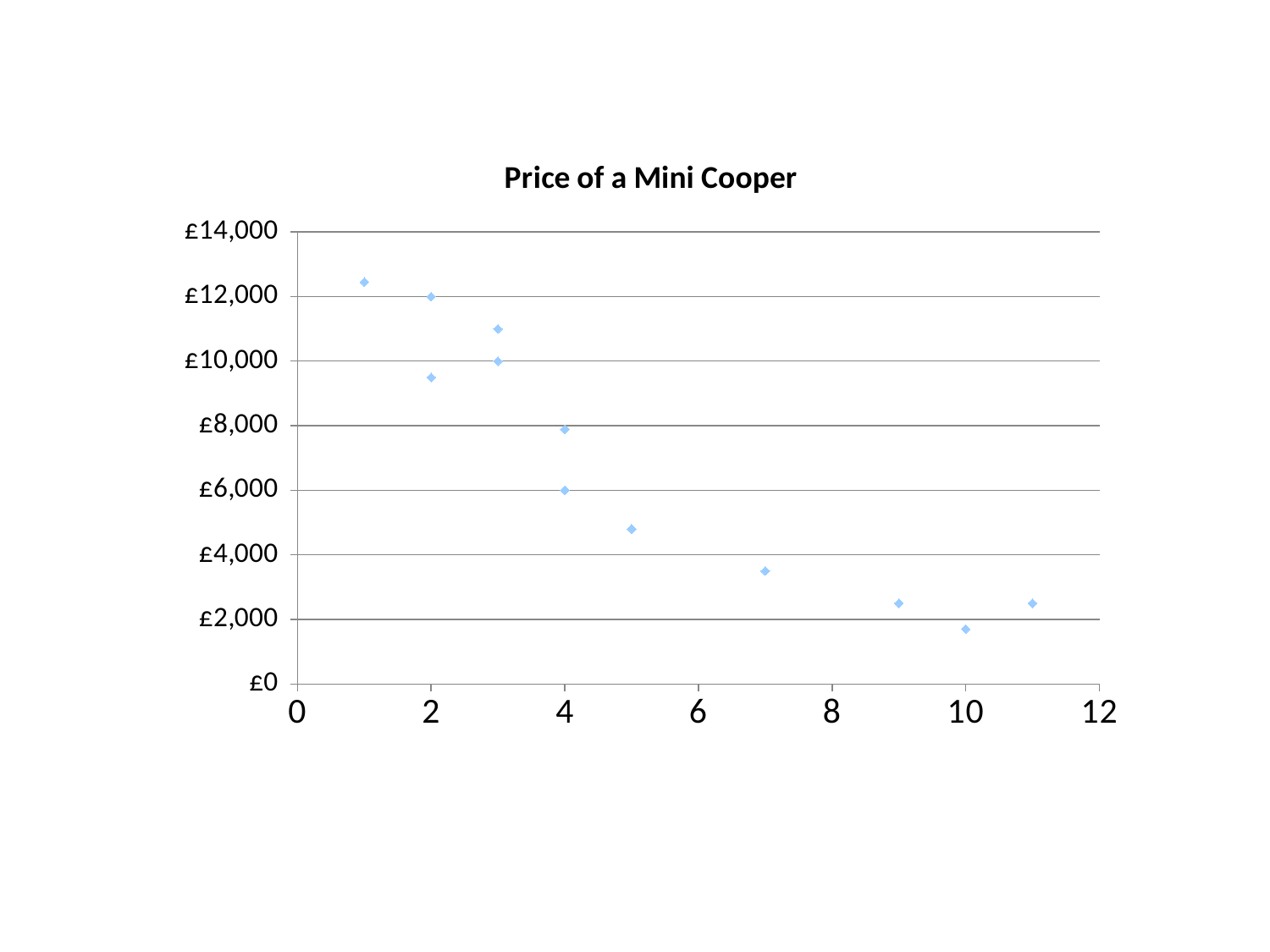
Do the prices generally rise or fall as the x value increases? fall Which has the higher price, the point at x = 7 or the point at x = 9? x = 7 At which x value is the highest price plotted? 1 What is the title of the chart? Price of a Mini Cooper Is the value for the point at x = 10 greater or less than £2,000? less At which x value is the lowest price plotted? 10 How many data points are plotted on the chart? 12 Is the value for the point at x = 1 greater or less than £12,000? greater Is the value for the point at x = 9 greater or less than £2,000? greater What kind of chart is shown on the slide? scatter chart